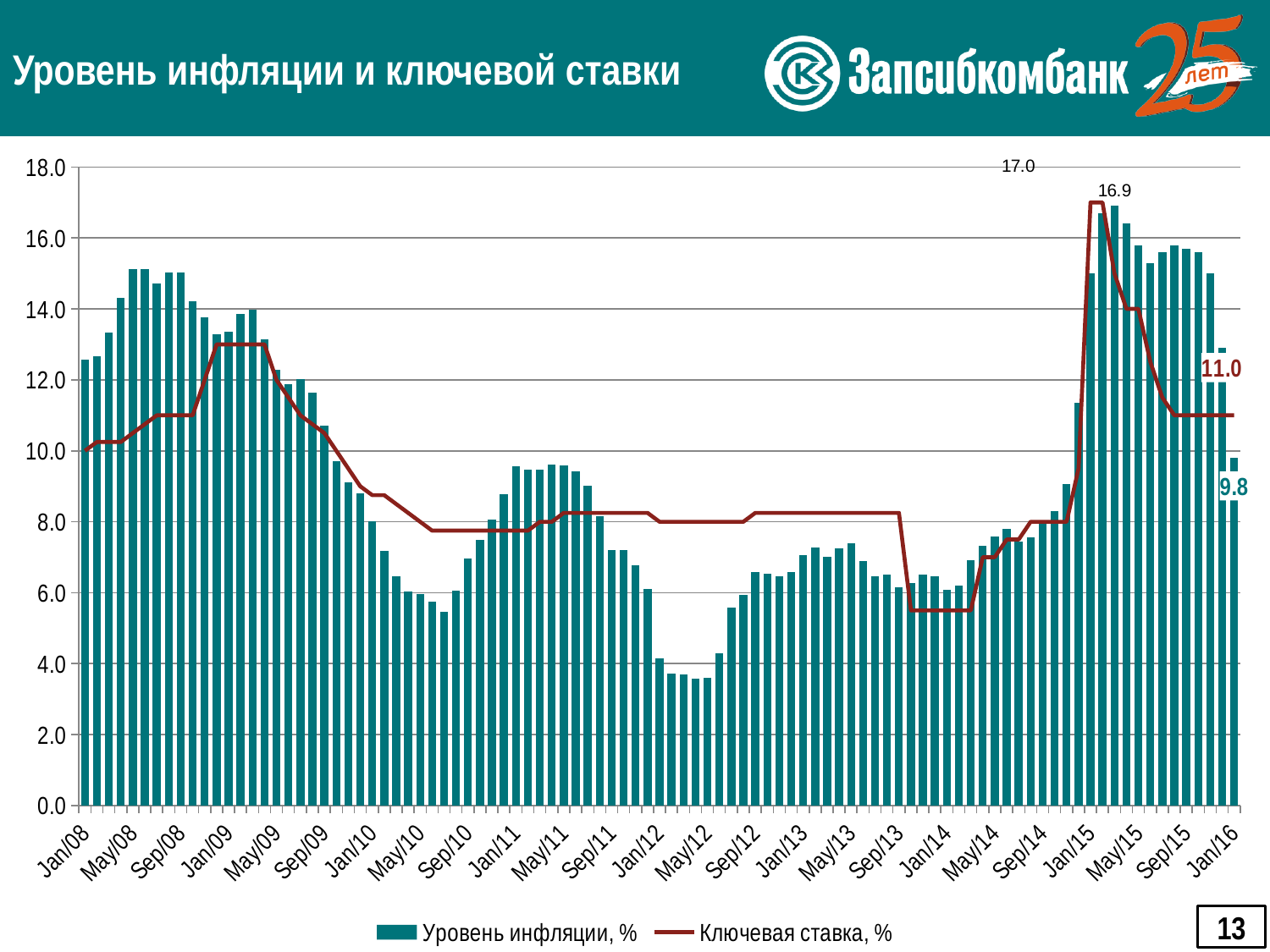
How many series does the legend list? 2 What is the inflation rate value labelled for Jan/16? 9.8 Is the inflation rate for May/12 greater or less than 4.0? less What is the key rate value labelled at the end of the series (Jan/16)? 11.0 What is the title of the chart? Уровень инфляции и ключевой ставки What are the two series named in the legend? Уровень инфляции, % and Ключевая ставка, % What is the highest labelled value of the inflation (Уровень инфляции) bars? 16.9 What kind of chart is shown on the slide? A bar chart combined with a line What is the difference between the key rate (11.0) and the inflation rate (9.8) at Jan/16? 1.2 Is the inflation rate for Jan/08 greater or less than 12.0? greater What is the highest labelled value of the key rate (Ключевая ставка) line? 17.0 At Jan/16, which is larger: the inflation rate or the key rate? Key rate (Ключевая ставка)